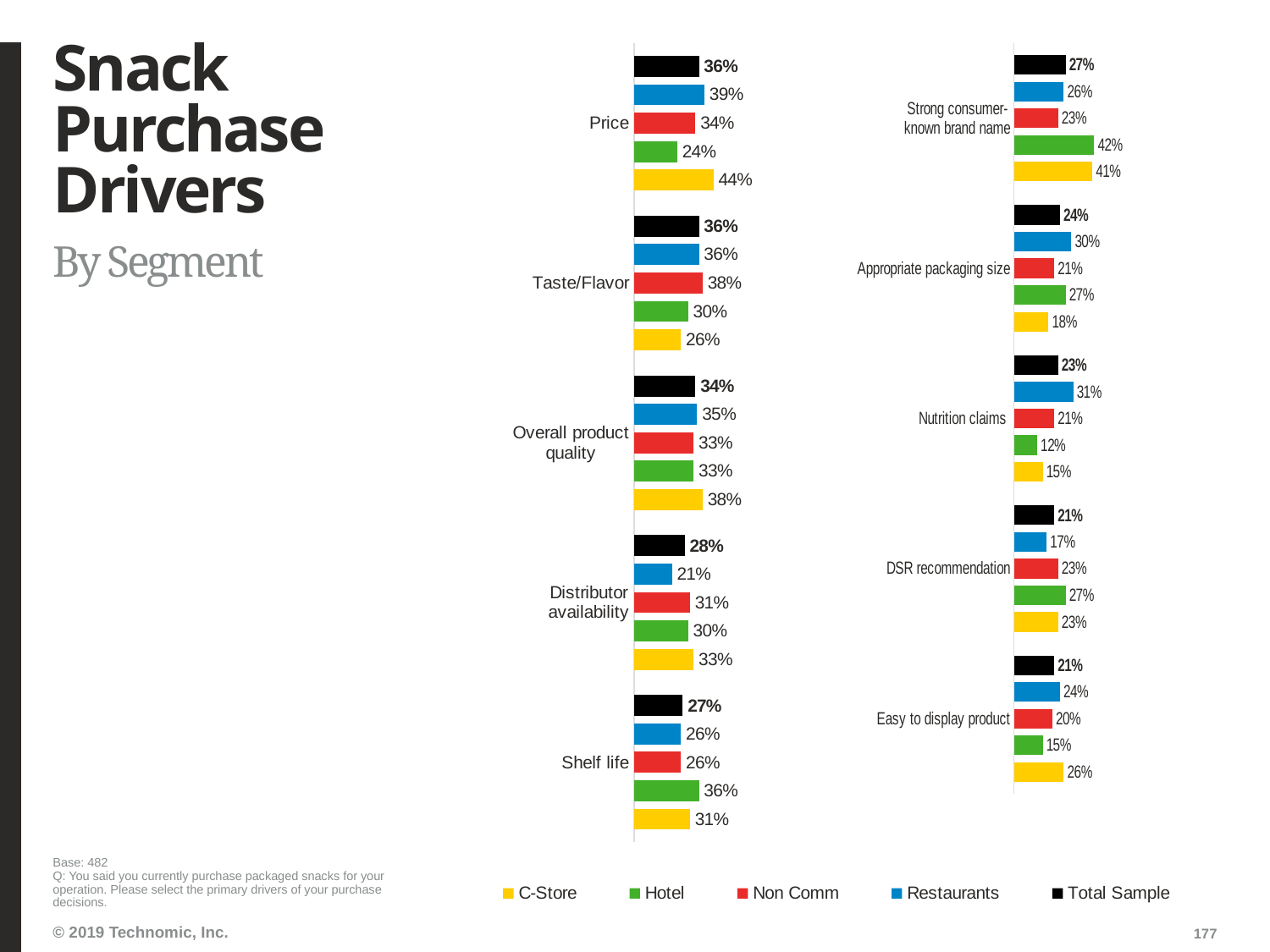
In the right chart, which segment has the highest value for Strong consumer-known brand name? Hotel In the left chart, what is the C-Store value for Price? 44% In the right chart, which segment has the lowest value for Nutrition claims? Hotel What type of chart is used on this slide? Bar chart In the right chart, what is the difference between the Restaurants and C-Store values for Appropriate packaging size? 12% How many categories are shown in the left chart? 5 In the right chart, what is the Restaurants value for Nutrition claims? 31% In the left chart, which is larger for Distributor availability: the Non Comm value or the Restaurants value? Non Comm In the right chart, what is the Total Sample value for Appropriate packaging size? 24% How many series does the legend list? 5 In the left chart, what is the Hotel value for Shelf life? 36% In the left chart, what is the difference between the C-Store and Hotel values for Price? 20%